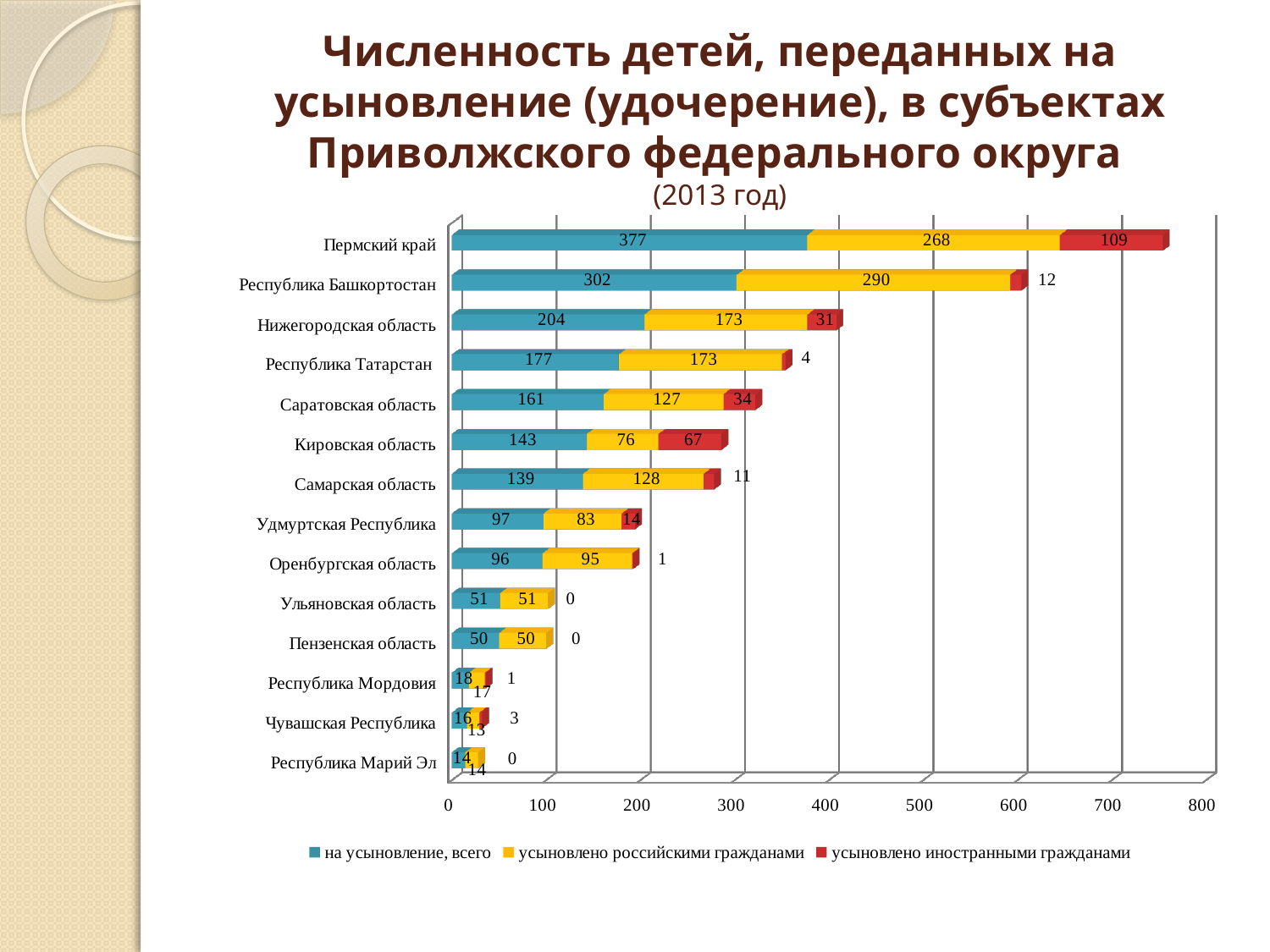
What is the difference between the "на усыновление, всего" values for Пермский край and Республика Башкортостан? 75 Which region has the lowest value for "на усыновление, всего"? Республика Марий Эл How many series does the legend list? 3 What is the value of "усыновлено иностранными гражданами" for Кировская область? 67 Which is larger: the "усыновлено иностранными гражданами" value for Саратовская область or for Нижегородская область? Саратовская область What type of chart is shown on the slide? bar chart What is the total of the stacked bar for Пермский край? 754 What is the value of "усыновлено российскими гражданами" for Республика Башкортостан? 290 Which colour represents "усыновлено иностранными гражданами" in the chart? red Which region has the highest value for "на усыновление, всего"? Пермский край How many regions (categories) are shown in the chart? 14 What is the value of "на усыновление, всего" for Пермский край? 377